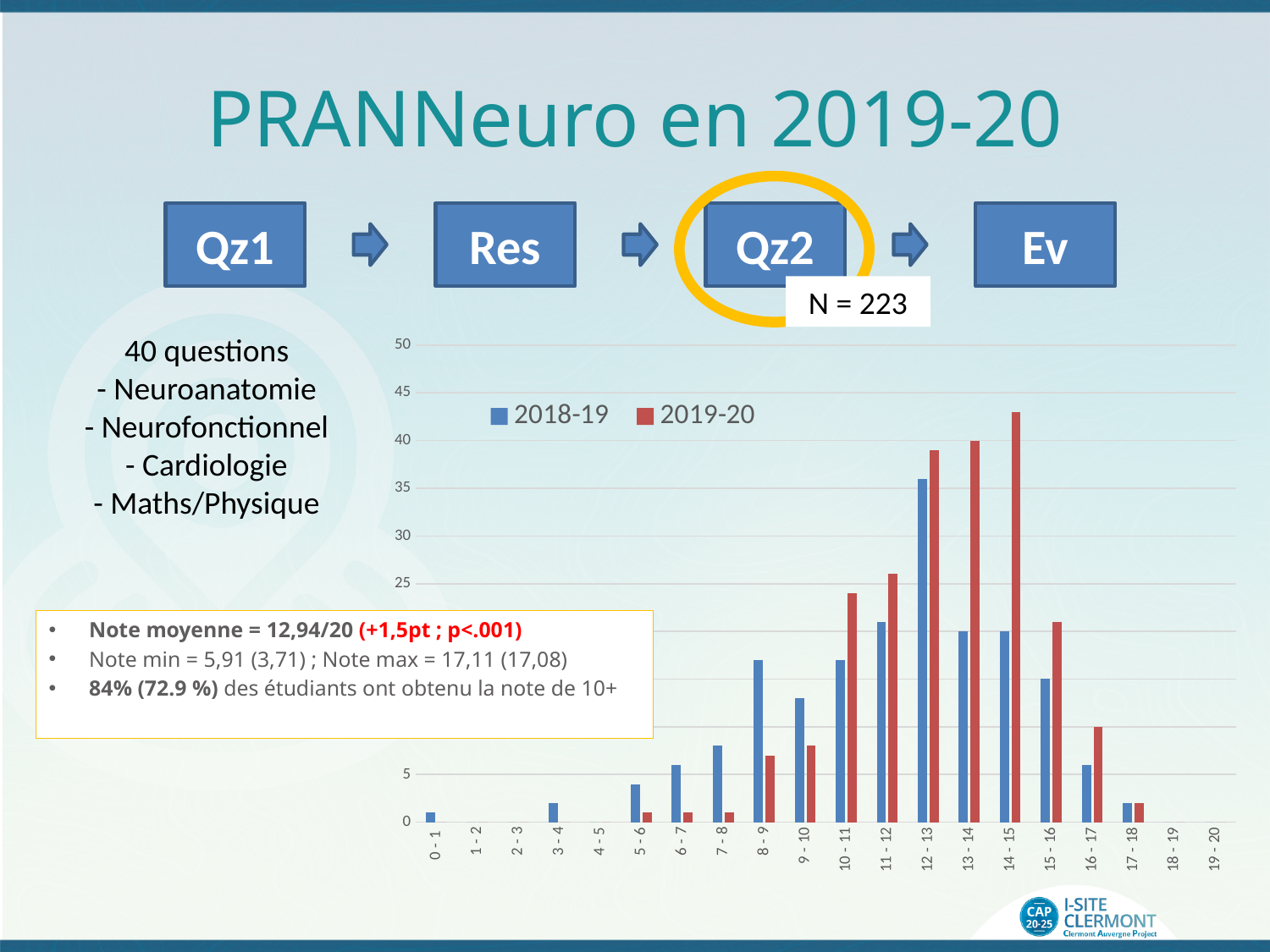
Which score range has the highest bar for the 2019-20 series? 14 - 15 What kind of chart is shown on the slide? bar chart Is the 2018-19 value for the 15 - 16 range greater or less than 20? less For the 8 - 9 range, which series has the larger value, 2018-19 or 2019-20? 2018-19 For the 15 - 16 range, which series has the larger value, 2018-19 or 2019-20? 2019-20 Which colour represents the 2019-20 series in the chart? red How many series does the chart legend list? 2 Which score range has the highest bar for the 2018-19 series? 12 - 13 How many score-range categories are shown on the x axis of the chart? 20 Is the 2019-20 value for the 14 - 15 range greater or less than 40? greater Is the 2019-20 value for the 16 - 17 range greater or less than 15? less